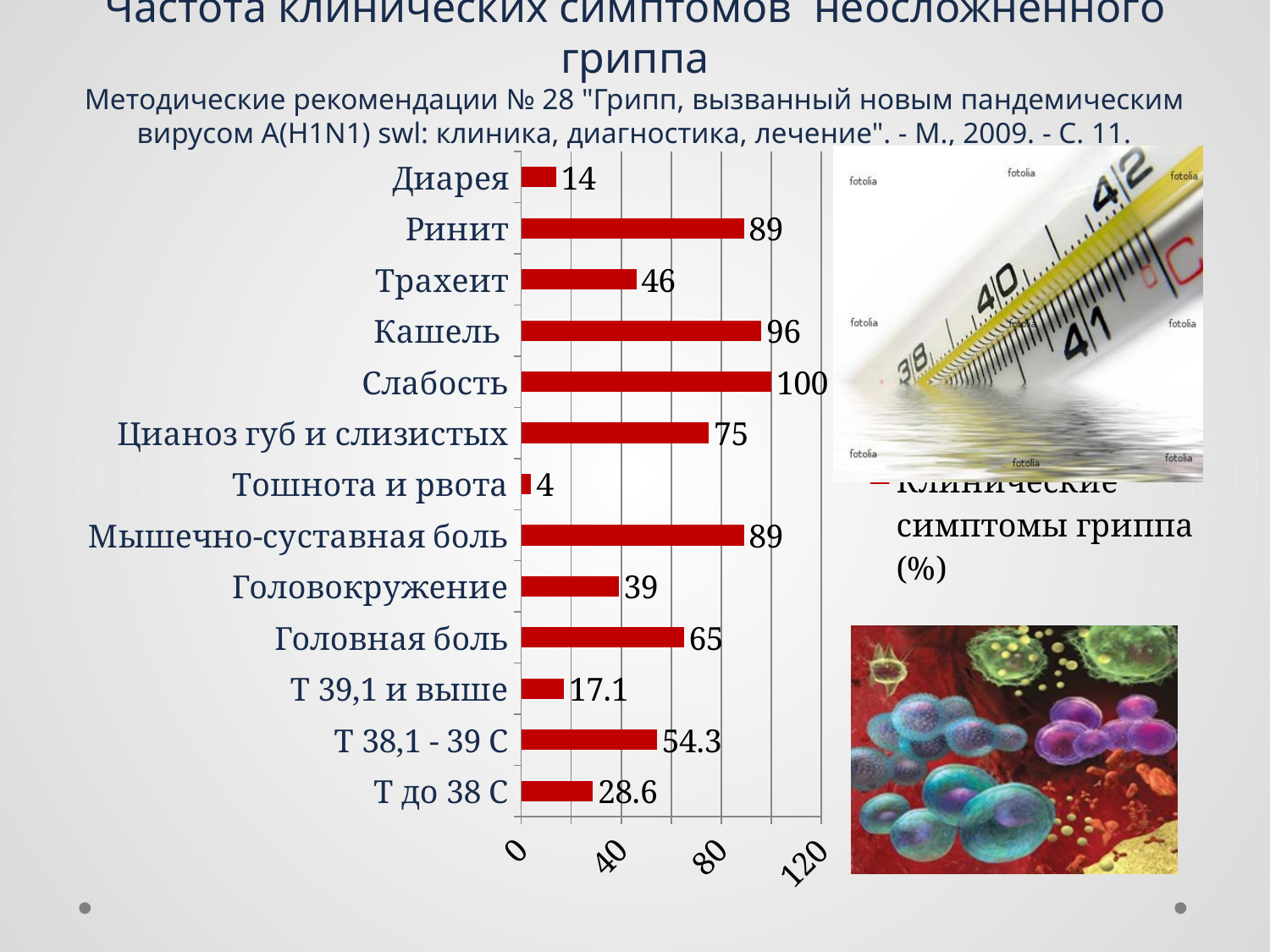
What kind of chart is shown on the slide? bar chart What is the difference between the values for Т 38,1 - 39 С and Т до 38 С? 25.7 What is the value for Головокружение? 39 Which is larger, the value for Ринит or the value for Головная боль? Ринит Which category has the lowest value? Тошнота и рвота How many categories are shown in the chart? 13 Is the value for Цианоз губ и слизистых greater or less than 40? greater What is the value for Слабость? 100 Which category has the highest value? Слабость What is the difference between the values for Кашель and Трахеит? 50 What is the value for Т 38,1 - 39 С? 54.3 What is the value for Трахеит? 46